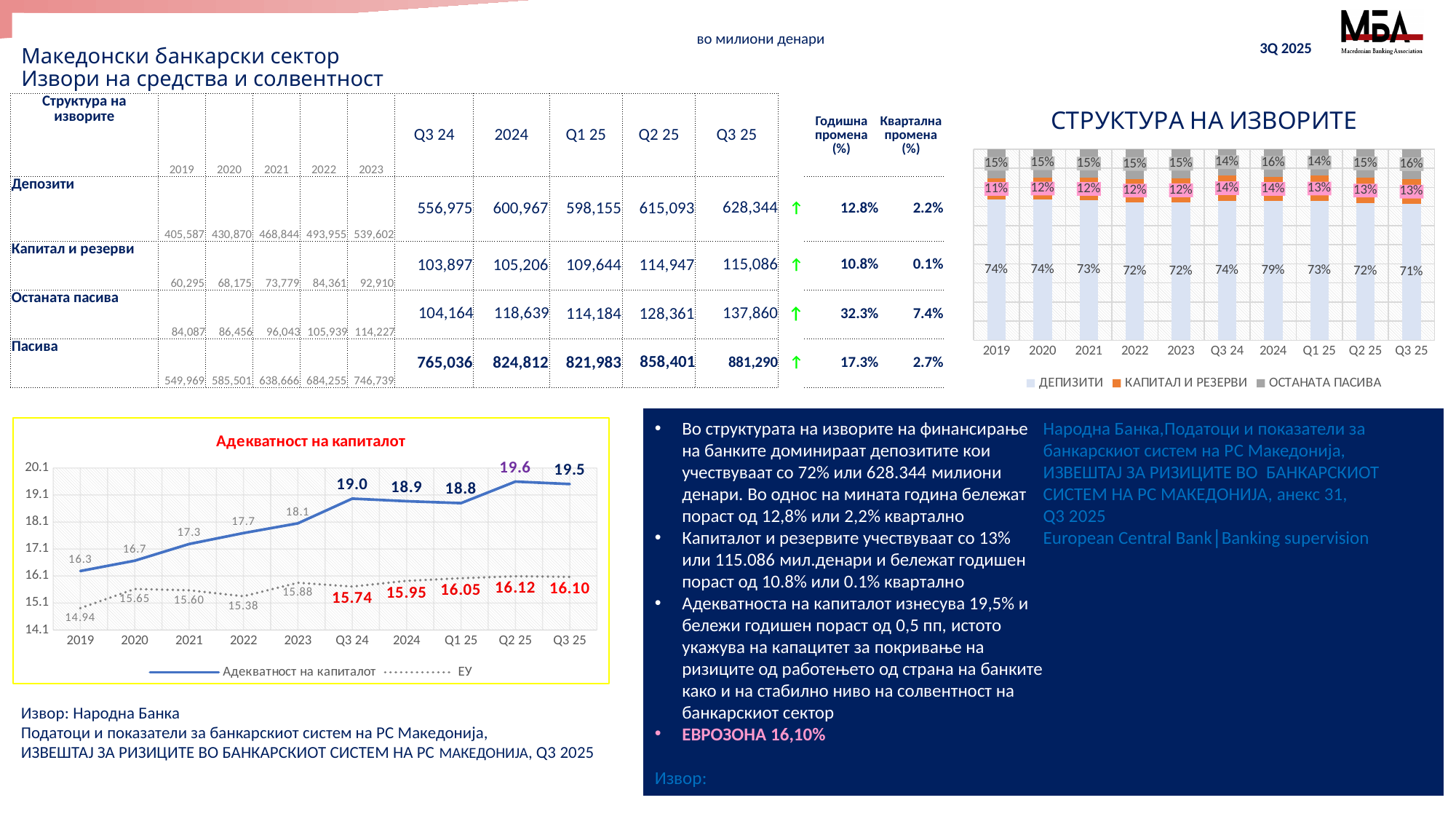
What kind of chart is 'СТРУКТУРА НА ИЗВОРИТЕ'? Stacked bar chart How many series does the legend of the 'СТРУКТУРА НА ИЗВОРИТЕ' chart list? 3 In the 'Адекватност на капиталот' chart, does the 'Адекватност на капиталот' series rise or fall from 2019 to 2023? Rise How many periods are shown on the x axis of the 'Адекватност на капиталот' chart? 10 In the 'Адекватност на капиталот' chart, in which period is the 'ЕУ' series lowest? 2019 In the 'Адекватност на капиталот' chart, what is the difference between the 'Адекватност на капиталот' values for Q3 25 and 2019? 3.2 In the 'СТРУКТУРА НА ИЗВОРИТЕ' chart, is the deposits share larger in 2024 or in Q3 25? 2024 In the 'СТРУКТУРА НА ИЗВОРИТЕ' chart, what share does 'КАПИТАЛ И РЕЗЕРВИ' have in 2019? 11% In the 'Адекватност на капиталот' chart, what is the value of 'Адекватност на капиталот' for Q2 25? 19.6 In the 'Адекватност на капиталот' chart, in which period is 'Адекватност на капиталот' highest? Q2 25 In the 'СТРУКТУРА НА ИЗВОРИТЕ' chart, what share do deposits (ДЕПИЗИТИ) have in Q3 25? 71% In the 'Адекватност на капиталот' chart, what is the value of the 'ЕУ' series for Q3 25? 16.10